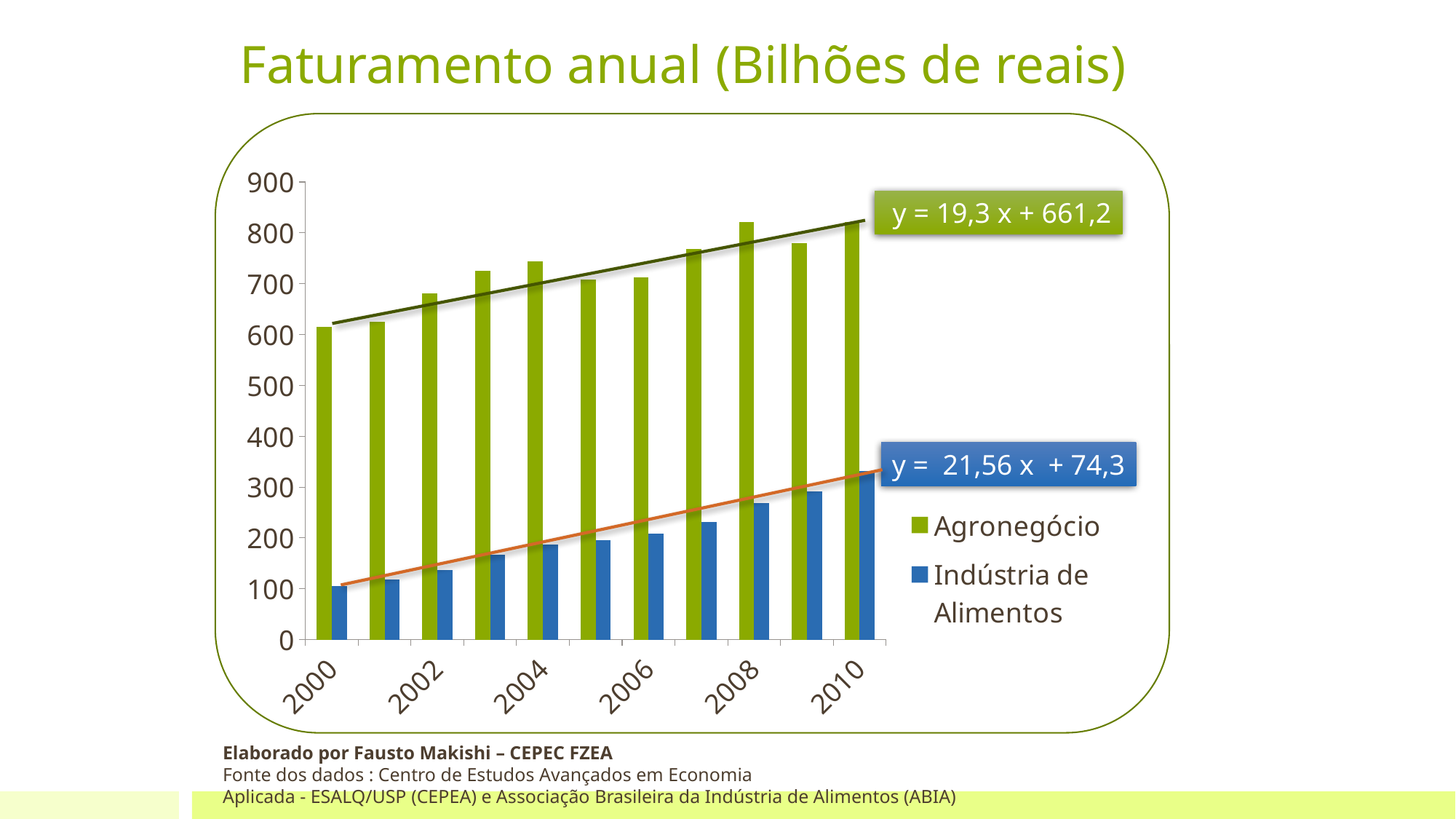
Do the Indústria de Alimentos values rise or fall from 2000 to 2010? rise How many years are plotted for each series? 11 In which year is the Indústria de Alimentos value highest? 2010 In 2010, which series has the larger value, Agronegócio or Indústria de Alimentos? Agronegócio Which series is shown in blue in the legend? Indústria de Alimentos What kind of chart is shown on the slide? bar chart In which year is the Indústria de Alimentos value lowest? 2000 How many series does the legend list? 2 What trendline equation is shown for the Agronegócio series? y = 19,3 x + 661,2 Is the value for Indústria de Alimentos in 2004 greater or less than 200? less Is the value for Agronegócio in 2008 greater or less than 800? greater Is the value for Indústria de Alimentos in 2010 greater or less than 300? greater